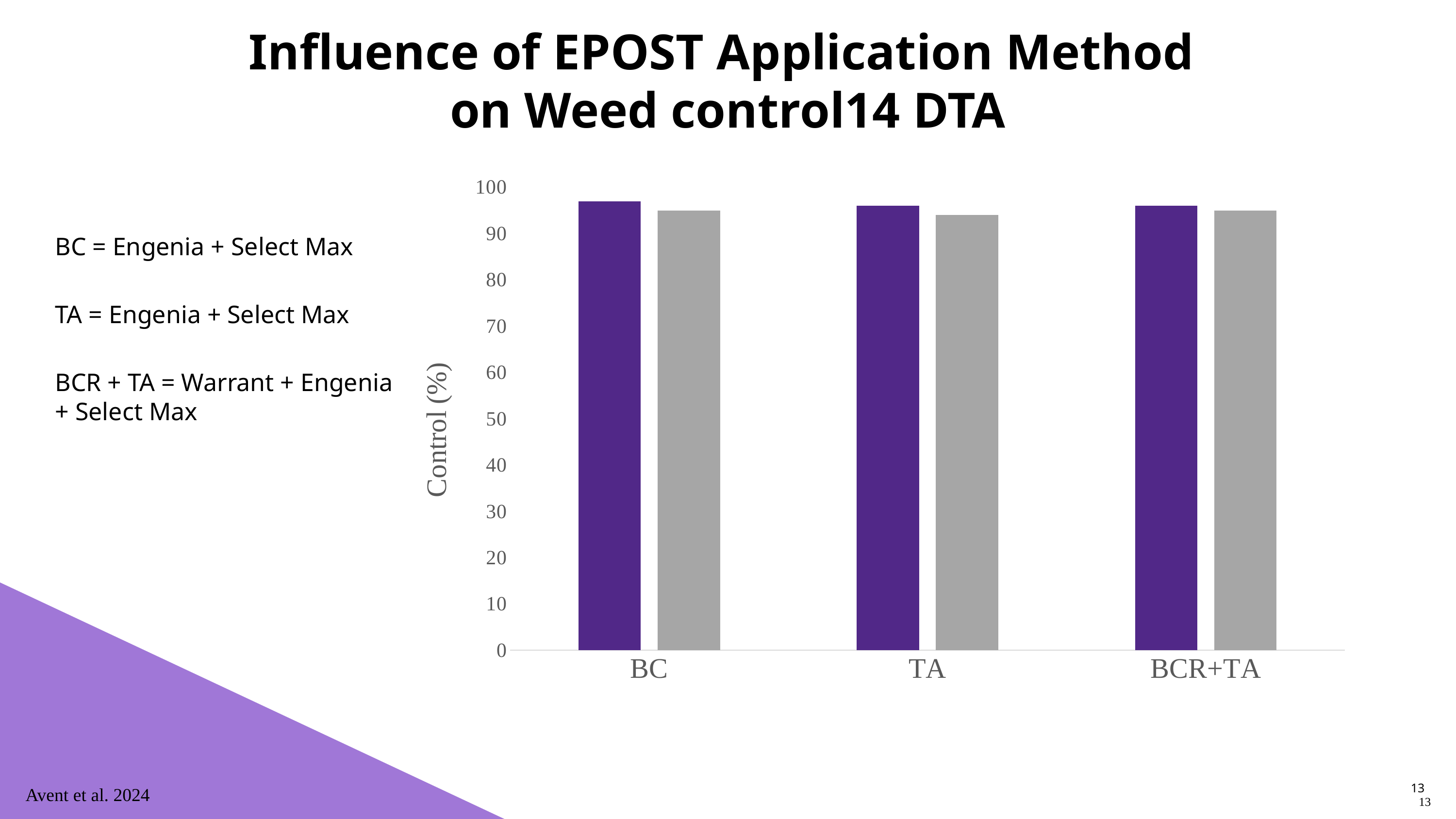
What kind of chart is shown on the slide? bar chart Is the value of the grey bar for BC greater or less than 50? greater What is the title of the slide containing the chart? Influence of EPOST Application Method on Weed control14 DTA What is the label of the y axis of the chart? Control (%) Is the value of the grey bar for BCR+TA greater or less than 100? less How many categories are shown on the x axis of the chart? 3 Is the value of the purple bar for BC greater or less than 90? greater What is the label of the third category on the x axis? BCR+TA